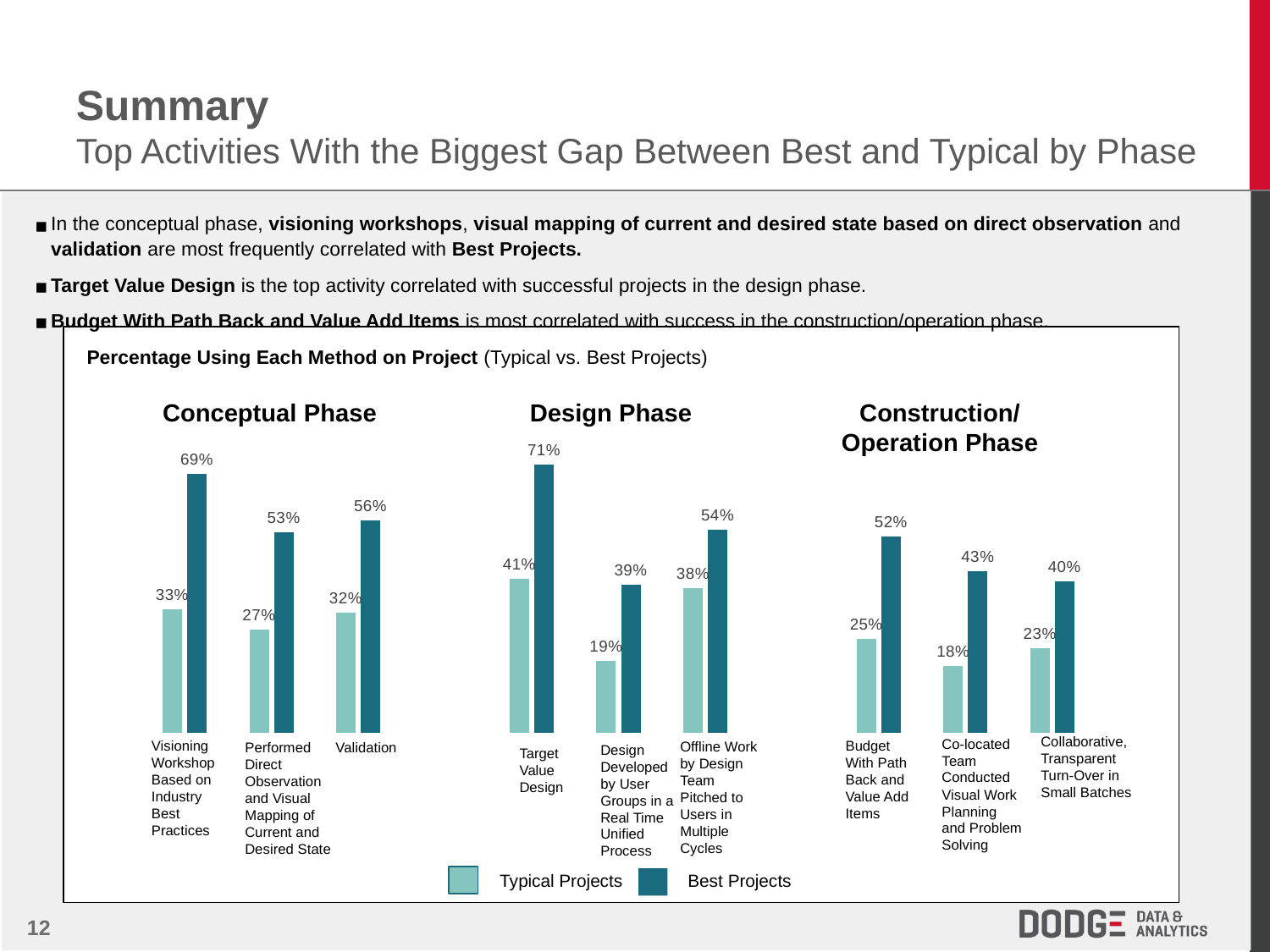
In the Design Phase chart, what percentage of Typical Projects used Target Value Design? 41% In the Conceptual Phase chart, what is the difference between Best Projects and Typical Projects for Validation? 24 percentage points How many activities are shown in the Construction/Operation Phase chart? 3 In the Conceptual Phase chart, which is larger for Typical Projects: Visioning Workshop Based on Industry Best Practices or Performed Direct Observation and Visual Mapping of Current and Desired State? Visioning Workshop Based on Industry Best Practices In the Construction/Operation Phase chart, what percentage of Best Projects used Budget With Path Back and Value Add Items? 52% In the Conceptual Phase chart, what percentage of Best Projects used a Visioning Workshop Based on Industry Best Practices? 69% In the Design Phase chart, which activity has the highest value for Best Projects? Target Value Design In the Design Phase chart, what is the difference between Best Projects and Typical Projects for Design Developed by User Groups in a Real Time Unified Process? 20 percentage points What are the two series named in the legend? Typical Projects and Best Projects What type of chart is used for the Design Phase? Bar chart In the Construction/Operation Phase chart, which activity has the lowest value for Typical Projects? Co-located Team Conducted Visual Work Planning and Problem Solving How many series does the legend list for the charts? 2